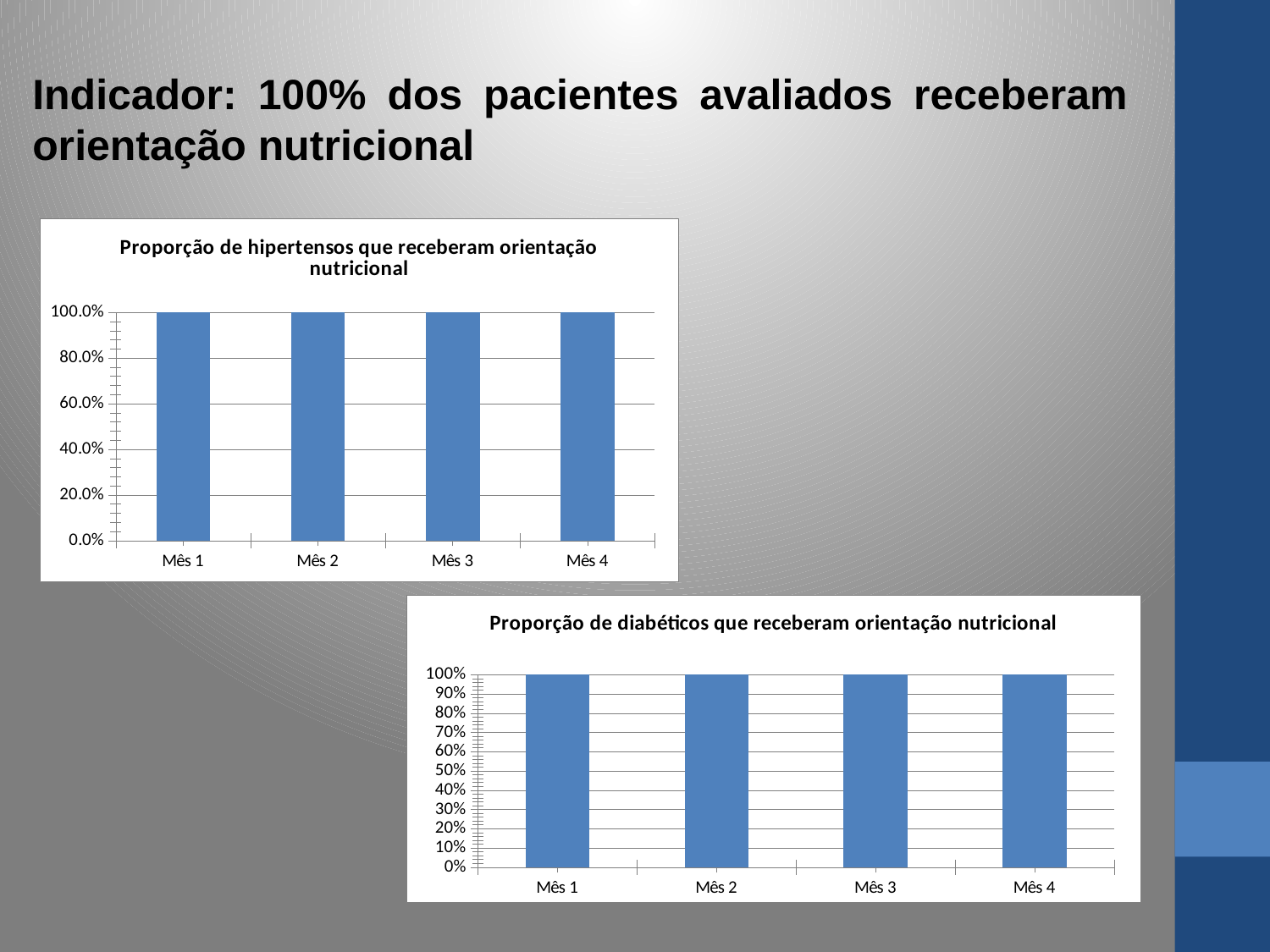
What is the title of the lower chart on the slide? Proporção de diabéticos que receberam orientação nutricional What kind of chart is the one titled 'Proporção de hipertensos que receberam orientação nutricional'? bar chart In the chart titled 'Proporção de hipertensos que receberam orientação nutricional', do the values rise, fall, or stay the same from Mês 1 to Mês 4? stay the same What kind of chart is the one titled 'Proporção de diabéticos que receberam orientação nutricional'? bar chart In the chart titled 'Proporção de diabéticos que receberam orientação nutricional', is the value for Mês 2 greater or less than 50%? greater In the chart titled 'Proporção de diabéticos que receberam orientação nutricional', do the values rise, fall, or stay the same across the months? stay the same In the chart titled 'Proporção de hipertensos que receberam orientação nutricional', what is the value for Mês 1? 100.0% In the chart titled 'Proporção de diabéticos que receberam orientação nutricional', how many bars are plotted? 4 In the chart titled 'Proporção de hipertensos que receberam orientação nutricional', what is the difference between the values for Mês 2 and Mês 4? 0.0% In the chart titled 'Proporção de hipertensos que receberam orientação nutricional', is the value for Mês 3 greater or less than 80.0%? greater In the chart titled 'Proporção de diabéticos que receberam orientação nutricional', what is the value for Mês 4? 100% In the chart titled 'Proporção de hipertensos que receberam orientação nutricional', how many categories are shown on the x axis? 4